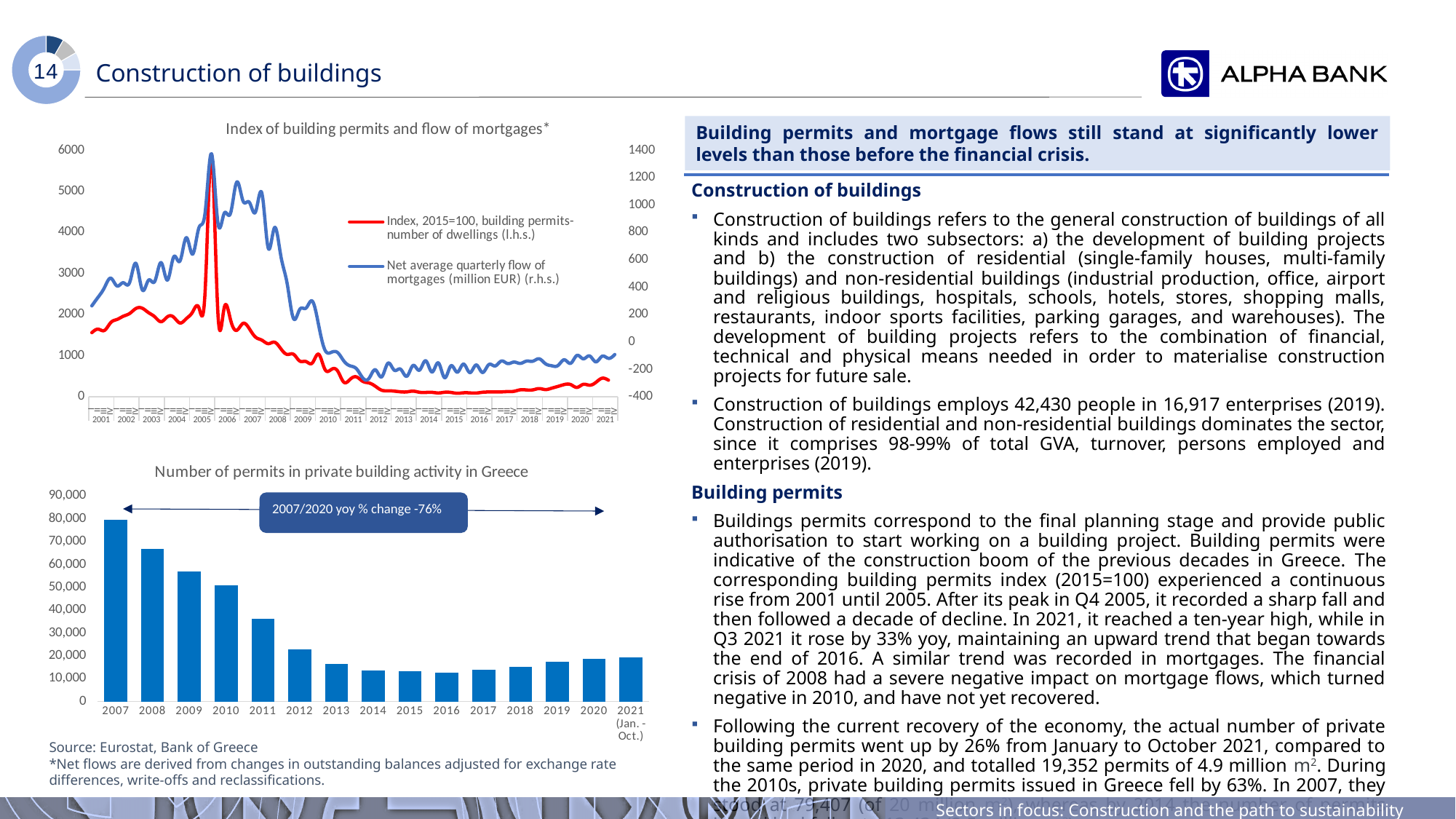
In 'Number of permits in private building activity in Greece', which year has the lowest number of permits? 2016 What kind of chart is 'Index of building permits and flow of mortgages*'? line chart In 'Number of permits in private building activity in Greece', do the values rise or fall from 2007 to 2016? fall In 'Number of permits in private building activity in Greece', which year has the highest number of permits? 2007 In 'Number of permits in private building activity in Greece', is the value for 2011 greater or less than 30,000? greater In 'Number of permits in private building activity in Greece', is the value for 2007 greater or less than 70,000? greater In 'Number of permits in private building activity in Greece', is the value for 2016 greater or less than 20,000? less How many series does the legend of 'Index of building permits and flow of mortgages*' list? 2 How many bars are shown in 'Number of permits in private building activity in Greece'? 15 In 'Number of permits in private building activity in Greece', which year has more permits, 2008 or 2010? 2008 What 2007/2020 yoy % change is annotated on 'Number of permits in private building activity in Greece'? -76% What kind of chart is 'Number of permits in private building activity in Greece'? bar chart